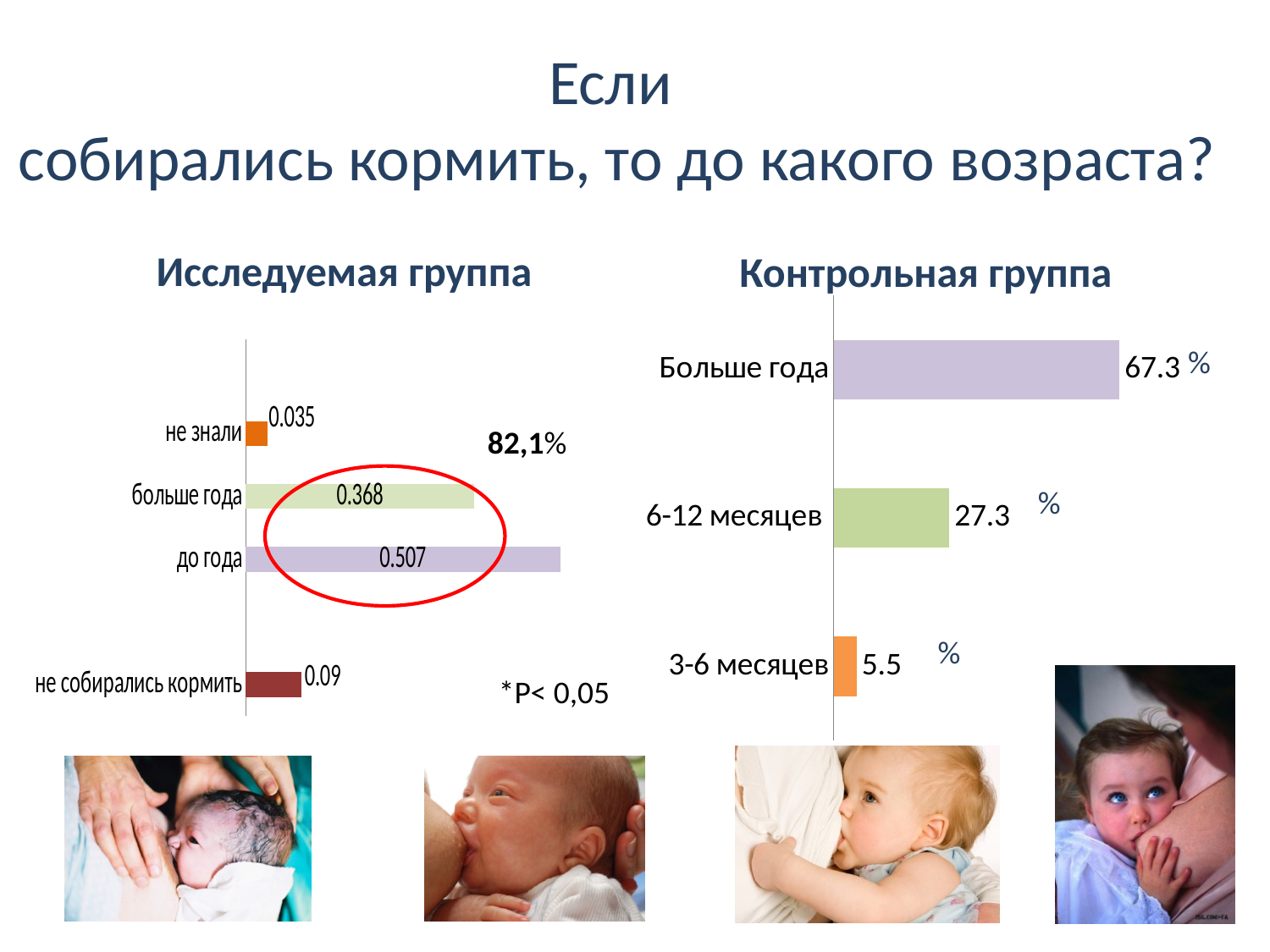
In the 'Исследуемая группа' chart, which is larger: 'больше года' or 'не собирались кормить'? больше года In the 'Контрольная группа' chart, what is the difference between 'Больше года' and '6-12 месяцев'? 40.0 In the 'Исследуемая группа' chart, what is the value for 'не знали'? 0.035 In the 'Контрольная группа' chart, what is the value for 'Больше года'? 67.3 What type of chart is the 'Контрольная группа' chart? bar chart In the 'Контрольная группа' chart, which category has the highest value? Больше года In the 'Контрольная группа' chart, what is the value for '3-6 месяцев'? 5.5 In the 'Исследуемая группа' chart, how many categories are shown? 4 In the 'Исследуемая группа' chart, what is the value for 'до года'? 0.507 In the 'Контрольная группа' chart, how many categories are shown? 3 In the 'Исследуемая группа' chart, which category has the lowest value? не знали In the 'Исследуемая группа' chart, which category has the highest value? до года